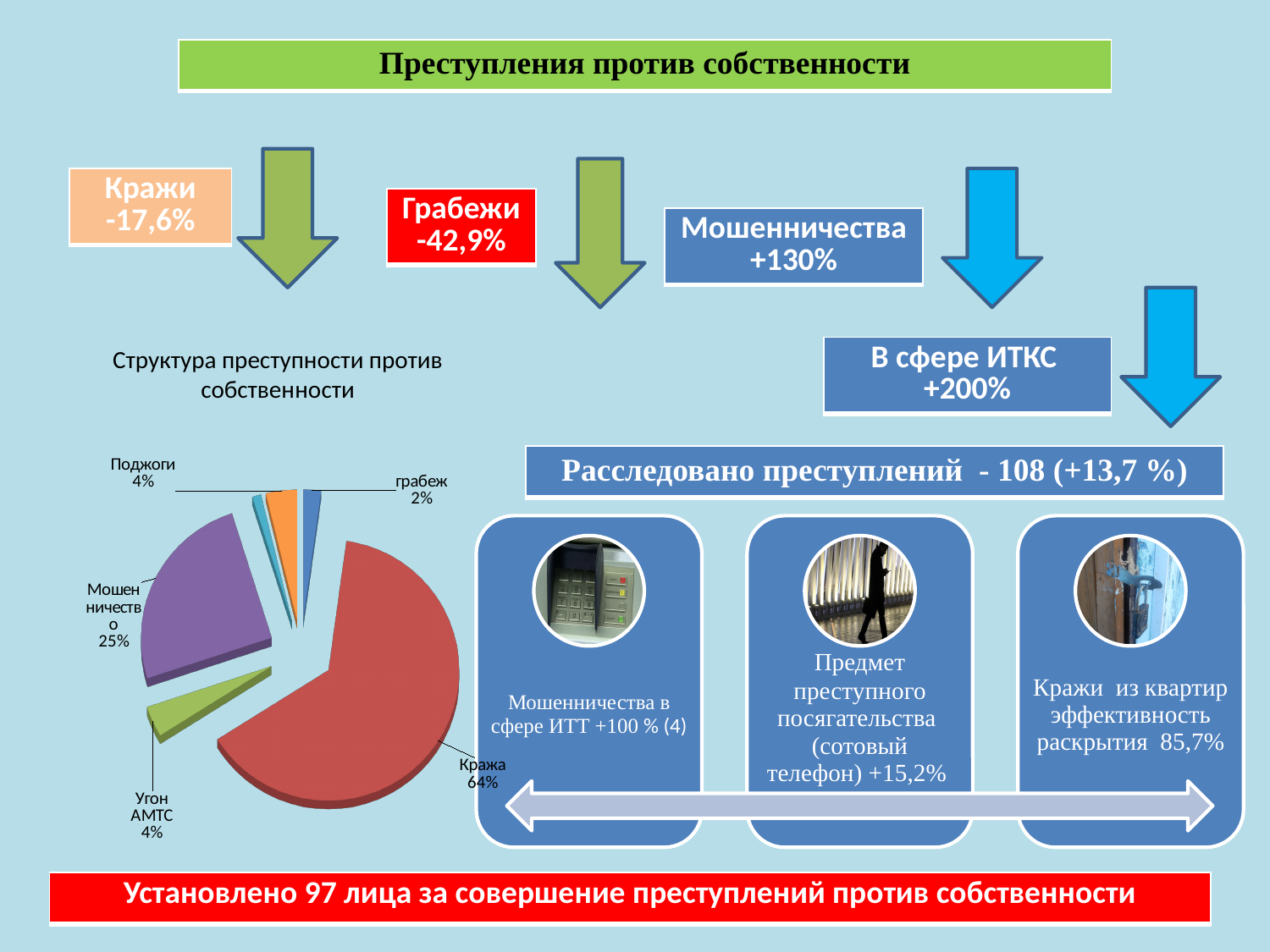
Is the share for Мошенничество in the pie chart greater or less than 20%? greater What is the value for Угон АМТС in the pie chart? 4% Which category has the largest slice in the pie chart? Кража What is the title of the pie chart? Структура преступности против собственности What is the combined share of Поджоги and Угон АМТС in the pie chart? 8% What percentage is shown for Поджоги in the pie chart? 4% What percentage is shown for грабеж in the pie chart? 2% What share of the pie chart does Кража account for? 64% Which is larger in the pie chart, Мошенничество or Поджоги? Мошенничество What kind of chart is used to show the structure of crimes against property? Pie chart What is the value shown for Мошенничество in the pie chart? 25% What is the difference between the shares of Кража and Мошенничество in the pie chart? 39%